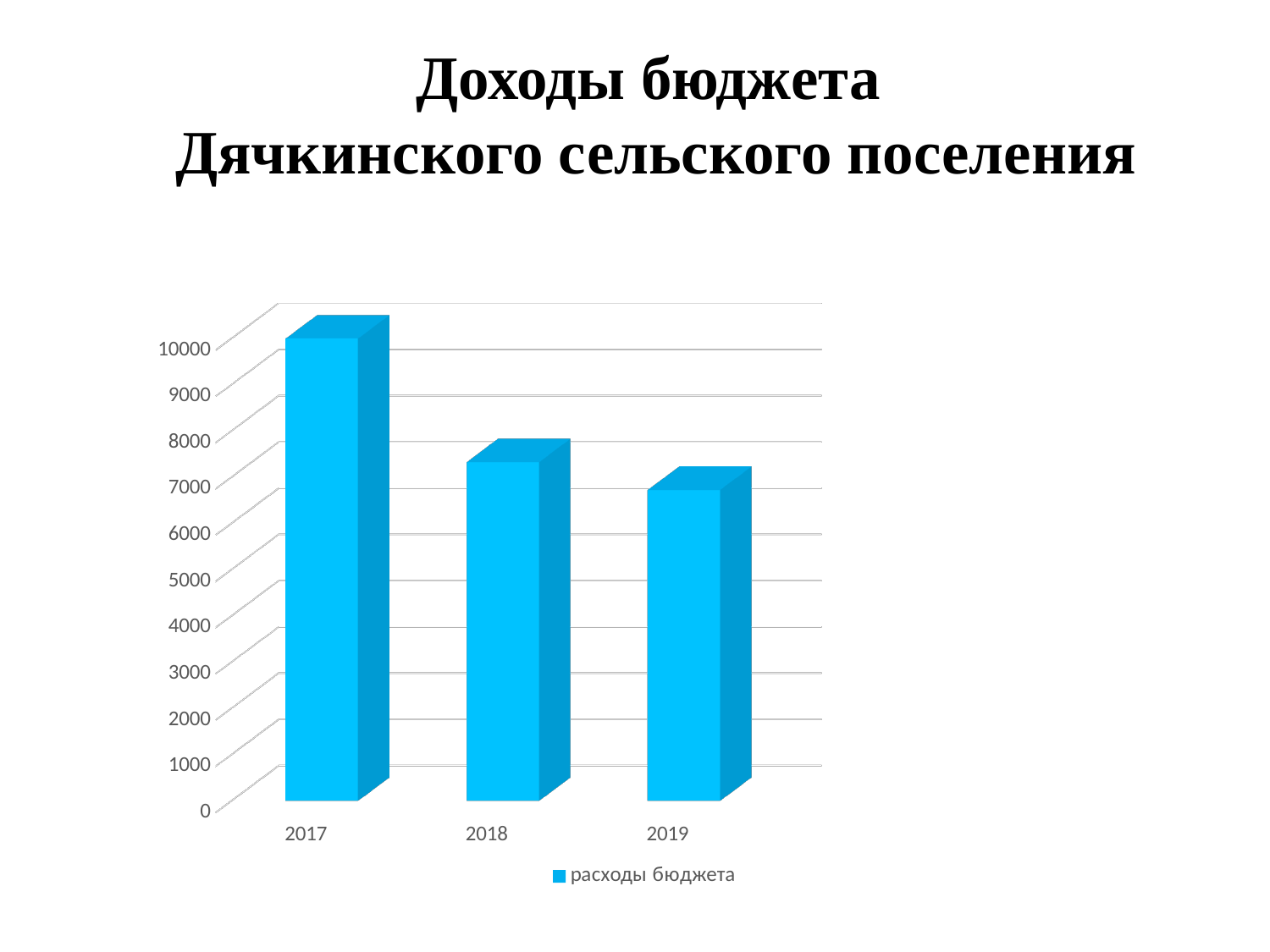
Is the value for 2018 greater or less than 9000? less What is the title of the slide above the chart? Доходы бюджета Дячкинского сельского поселения Is the value for 2017 greater or less than 9000? greater How many years are shown on the x axis of the chart? 3 Which year has the lowest bar in the chart? 2019 How many series does the chart legend list? 1 Do the values rise or fall from 2017 to 2019? fall Is the value for 2019 greater or less than 8000? less What kind of chart is shown on the slide? bar chart What is the series name shown in the chart legend? расходы бюджета Which year has the highest bar in the chart? 2017 Which is larger, the value for 2018 or the value for 2019? 2018